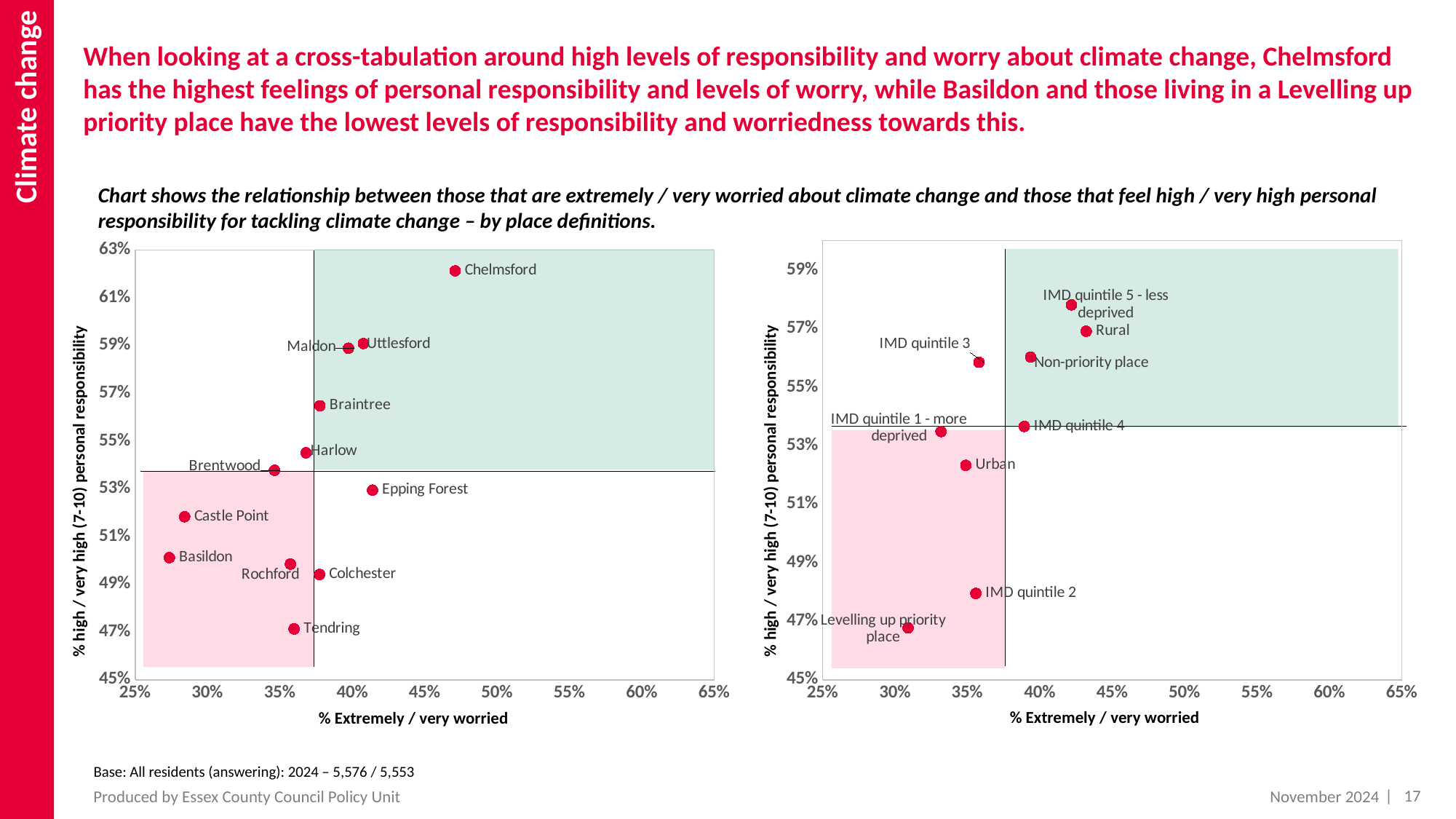
On the right chart, which place definition has the highest % high / very high personal responsibility? IMD quintile 5 - less deprived On the right chart (by place definitions), how many data points are plotted? 9 What kind of chart is the left chart on the slide? Scatter chart What is the x-axis label on the left chart? % Extremely / very worried On the left chart, which district has the lowest % high / very high personal responsibility? Tendring On the right chart, which place definition has the lowest % high / very high personal responsibility? Levelling up priority place On the left chart (by district), how many data points are plotted? 12 On the right chart, is the % extremely / very worried for Levelling up priority place greater or less than 35%? less On the left chart, is the % high / very high personal responsibility for Tendring greater or less than 49%? less On the left chart, is the % extremely / very worried for Chelmsford greater or less than 45%? greater On the left chart, which district has the highest % high / very high personal responsibility? Chelmsford On the left chart, which district has the lowest % extremely / very worried? Basildon